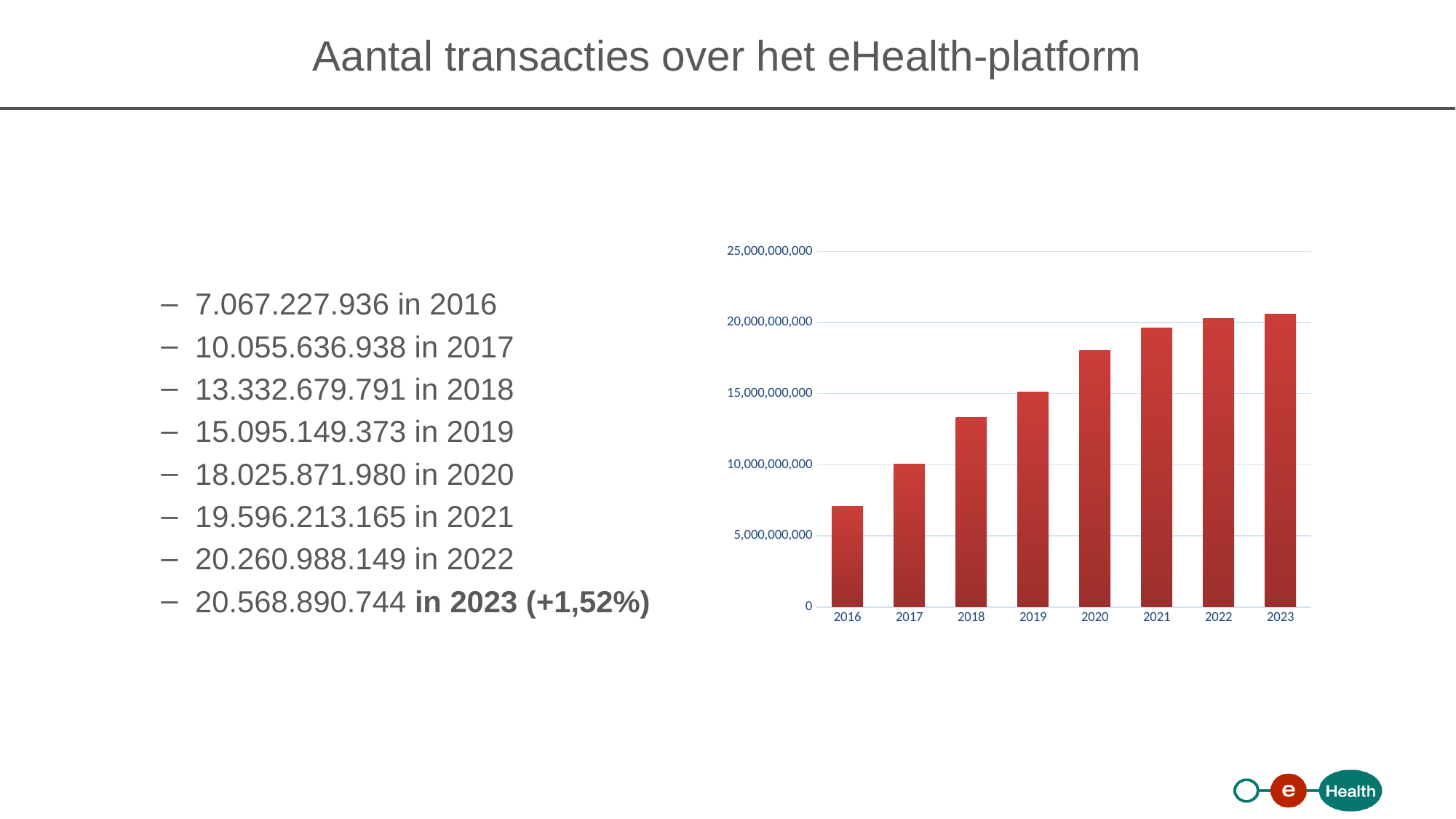
How many years are plotted on the x axis of the chart? 8 Is the value for 2018 greater or less than 10,000,000,000? greater Do the values in the chart rise or fall from 2016 to 2023? rise What kind of chart is shown on the slide? bar chart Is the value for 2016 greater or less than 10,000,000,000? less According to the slide, how many transactions were there in 2023? 20.568.890.744 Is the value for 2020 greater or less than 15,000,000,000? greater Which year had more transactions, 2019 or 2020? 2020 According to the slide, how many transactions were there in 2020? 18.025.871.980 What is the title of the slide containing the chart? Aantal transacties over het eHealth-platform Which year has the highest number of transactions in the chart? 2023 Which year has the lowest number of transactions in the chart? 2016